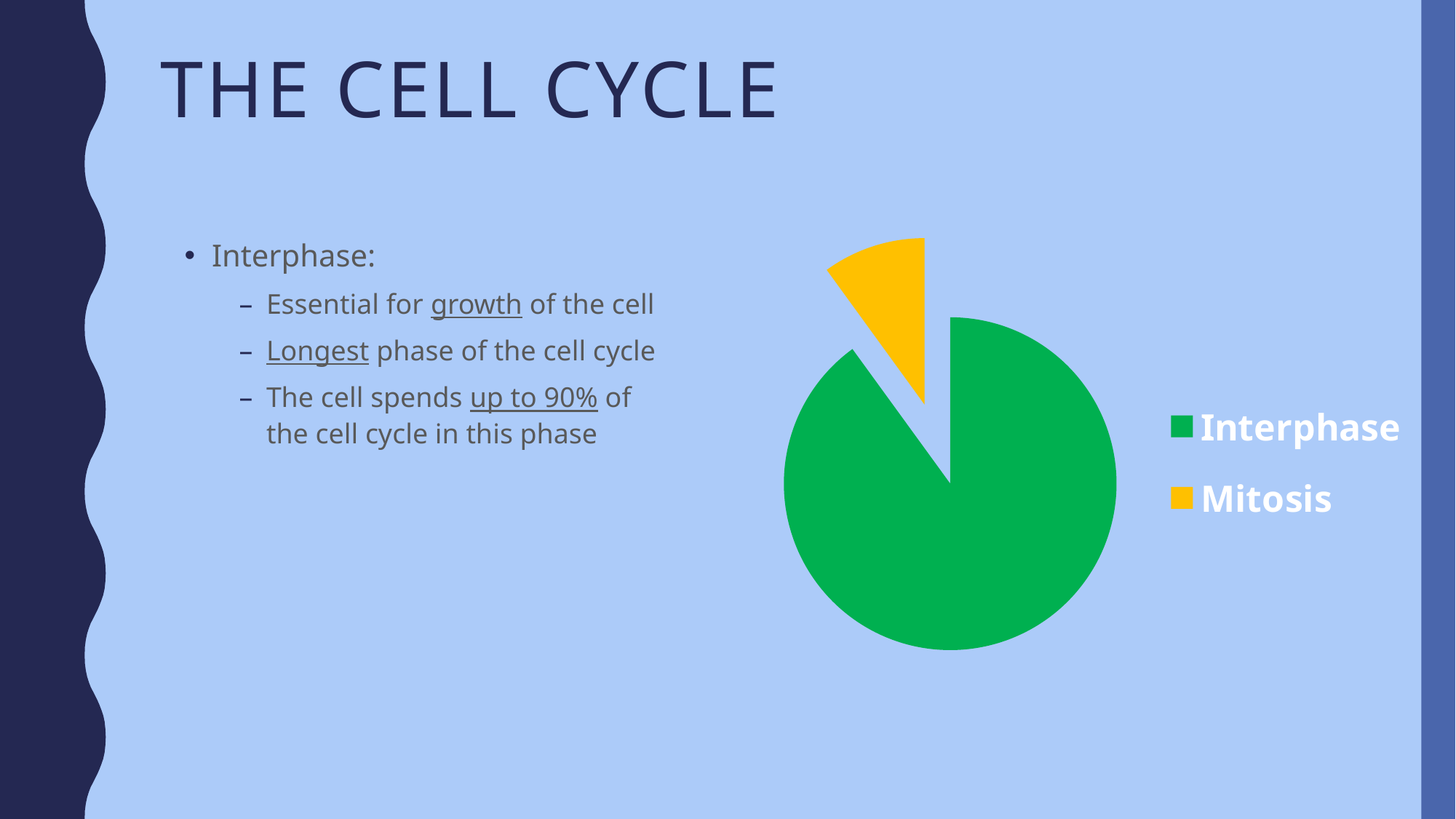
Which slice of the pie chart is the smallest? Mitosis Which legend entry is shown in yellow? Mitosis Which slice of the pie chart is the largest? Interphase What colour is the Interphase slice in the pie chart? green How many entries does the pie chart's legend list? 2 How many slices does the pie chart have? 2 Which slice is larger in the pie chart, Interphase or Mitosis? Interphase What kind of chart is shown on the slide? pie chart